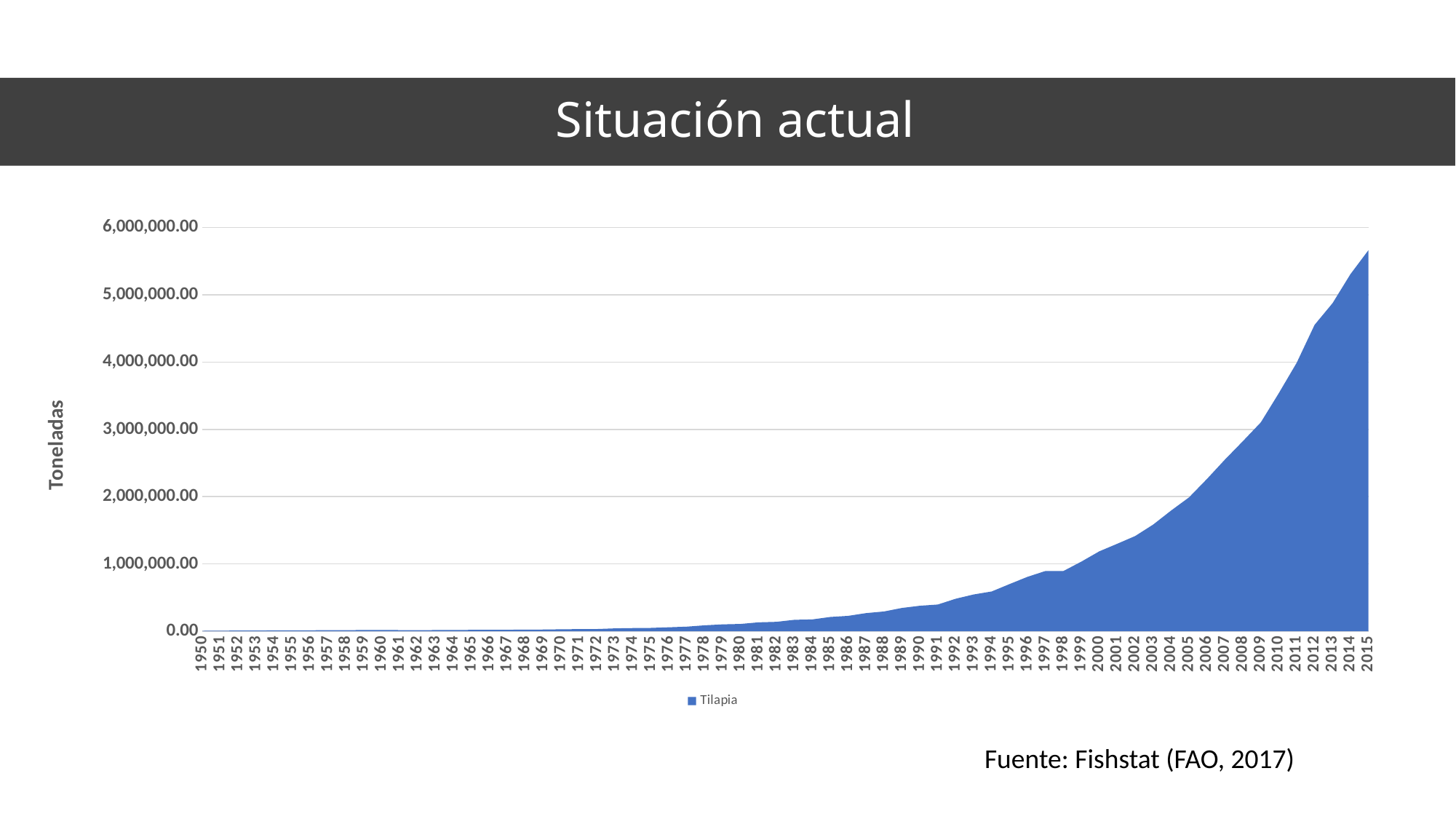
Is the Tilapia value for 2015 greater or less than 5,000,000.00? greater What kind of chart is shown on the slide? area chart Do the Tilapia values generally rise or fall from 1950 to 2015? rise Is the Tilapia value for 2000 greater or less than 2,000,000.00? less Which year has the highest Tilapia value? 2015 Is the Tilapia value for 1990 greater or less than 1,000,000.00? less Which year has the larger Tilapia value, 2000 or 2015? 2015 What is the label on the vertical axis? Toneladas How many years are plotted along the x axis? 66 How many series does the legend list? 1 What is the name of the series shown in the legend? Tilapia